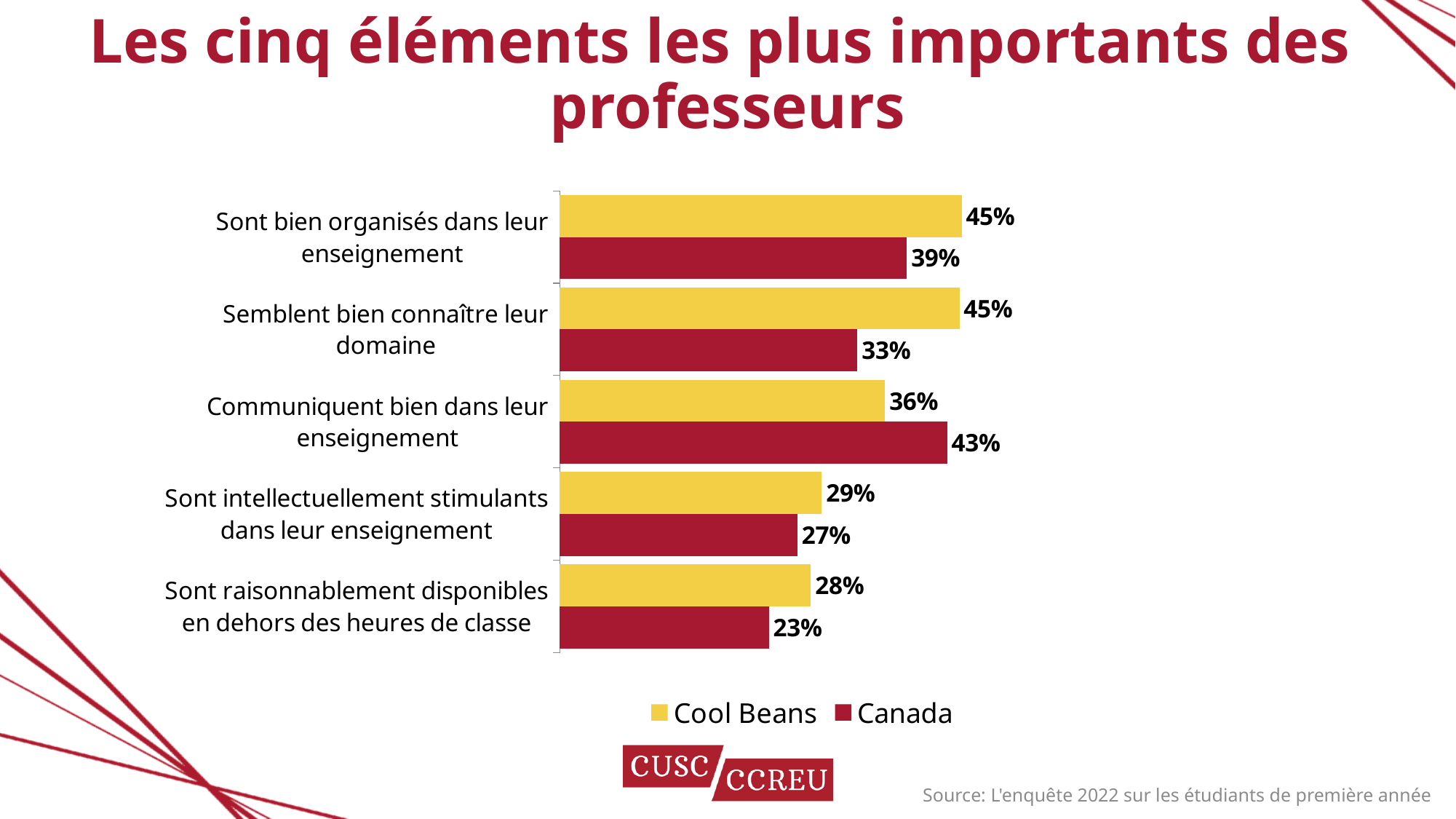
What is the difference between the Cool Beans and Canada values for "Sont intellectuellement stimulants dans leur enseignement"? 2% Which category has the lowest Cool Beans value? Sont raisonnablement disponibles en dehors des heures de classe Which category has the highest Canada value? Communiquent bien dans leur enseignement How many categories does the chart show? 5 What kind of chart is shown on the slide? Bar chart Which colour represents the Canada series? Red What is the Cool Beans value for "Sont bien organisés dans leur enseignement"? 45% What is the difference between the Cool Beans and Canada values for "Semblent bien connaître leur domaine"? 12% How many series does the legend list? 2 For "Communiquent bien dans leur enseignement", which is larger: the Cool Beans value or the Canada value? Canada What is the Canada value for "Sont raisonnablement disponibles en dehors des heures de classe"? 23% What is the Canada value for "Communiquent bien dans leur enseignement"? 43%